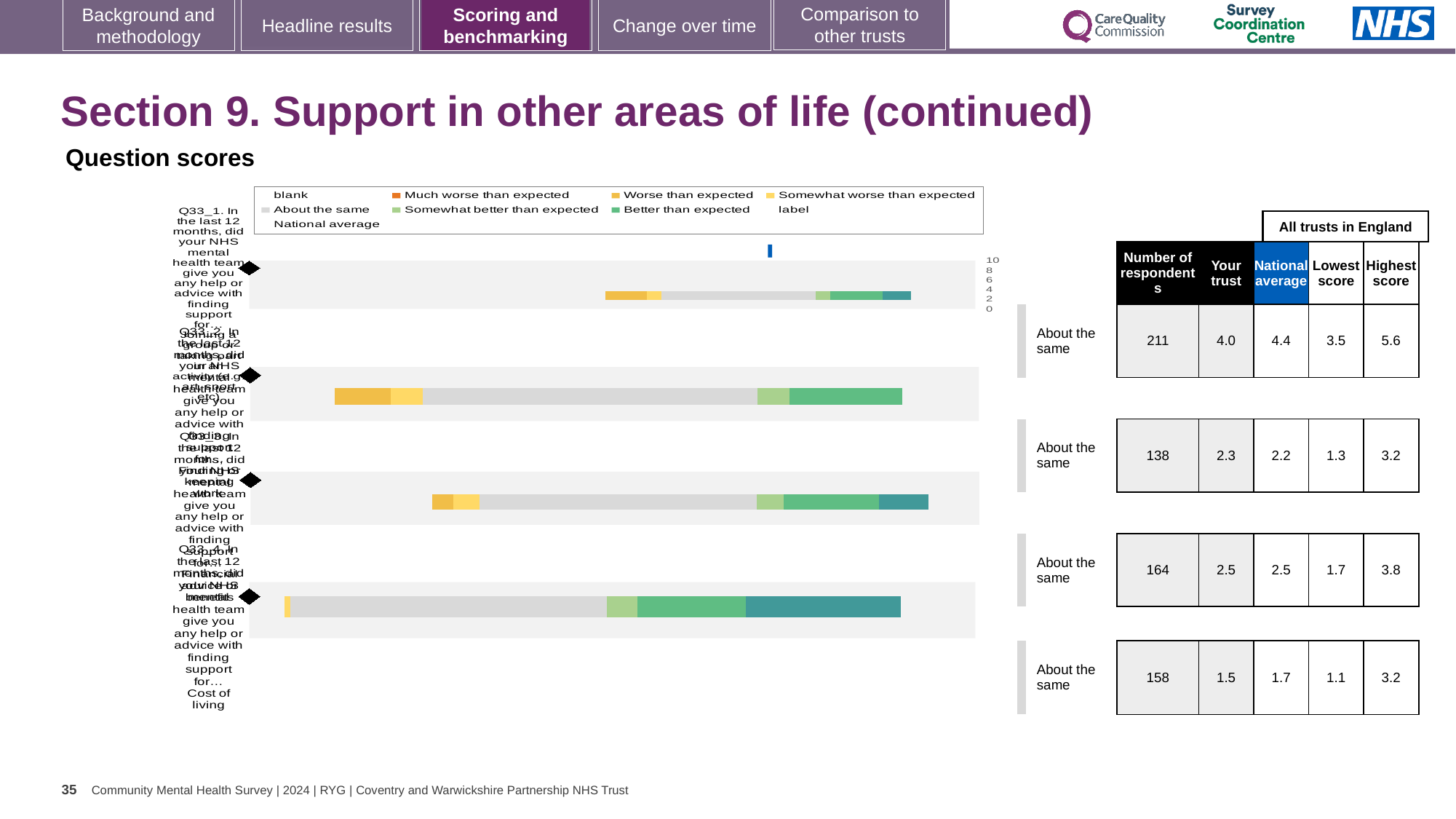
What kind of chart is shown on the slide? bar chart In the table beside the chart, what is the lowest score for the fourth (bottom) question? 1.1 In the table beside the chart, what is the national average for the second question? 2.2 Which question row has the highest number of respondents? the first (top) question, 211 For the first (top) question, which is larger: the 'Your trust' score or the national average? National average (4.4) How many question bars are plotted in the chart? 4 In the table beside the chart, what is the 'Your trust' score for the first (top) question? 4.0 In the table beside the chart, what is the number of respondents for the first (top) question? 211 How many entries does the chart legend list? 9 What is the difference in number of respondents between the first question (211) and the second question (138)? 73 Which question row has the lowest number of respondents? the second question, 138 In the table beside the chart, what is the highest score for the third question? 3.8